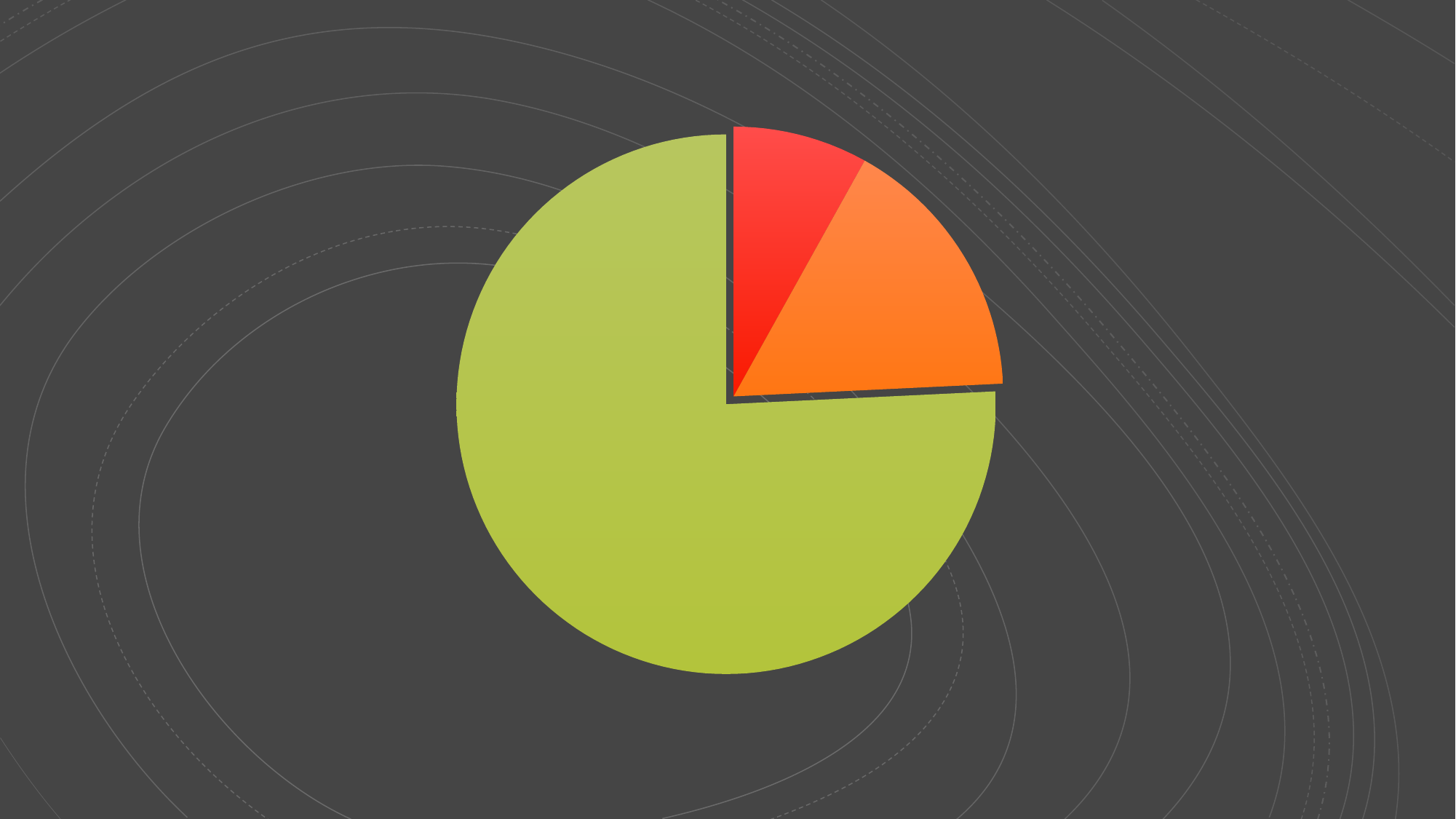
Does the pie chart display a legend? No Which slice of the pie chart is the largest? The green slice Does the pie chart show data labels on its slices? No What kind of chart is shown on the slide? Pie chart Which slice of the pie chart is the smallest? The red slice How many slices does the pie chart have? 3 Does the green slice take up more or less than half of the pie chart? More Which is larger in the pie chart, the green slice or the orange slice? The green slice Which is larger in the pie chart, the orange slice or the red slice? The orange slice